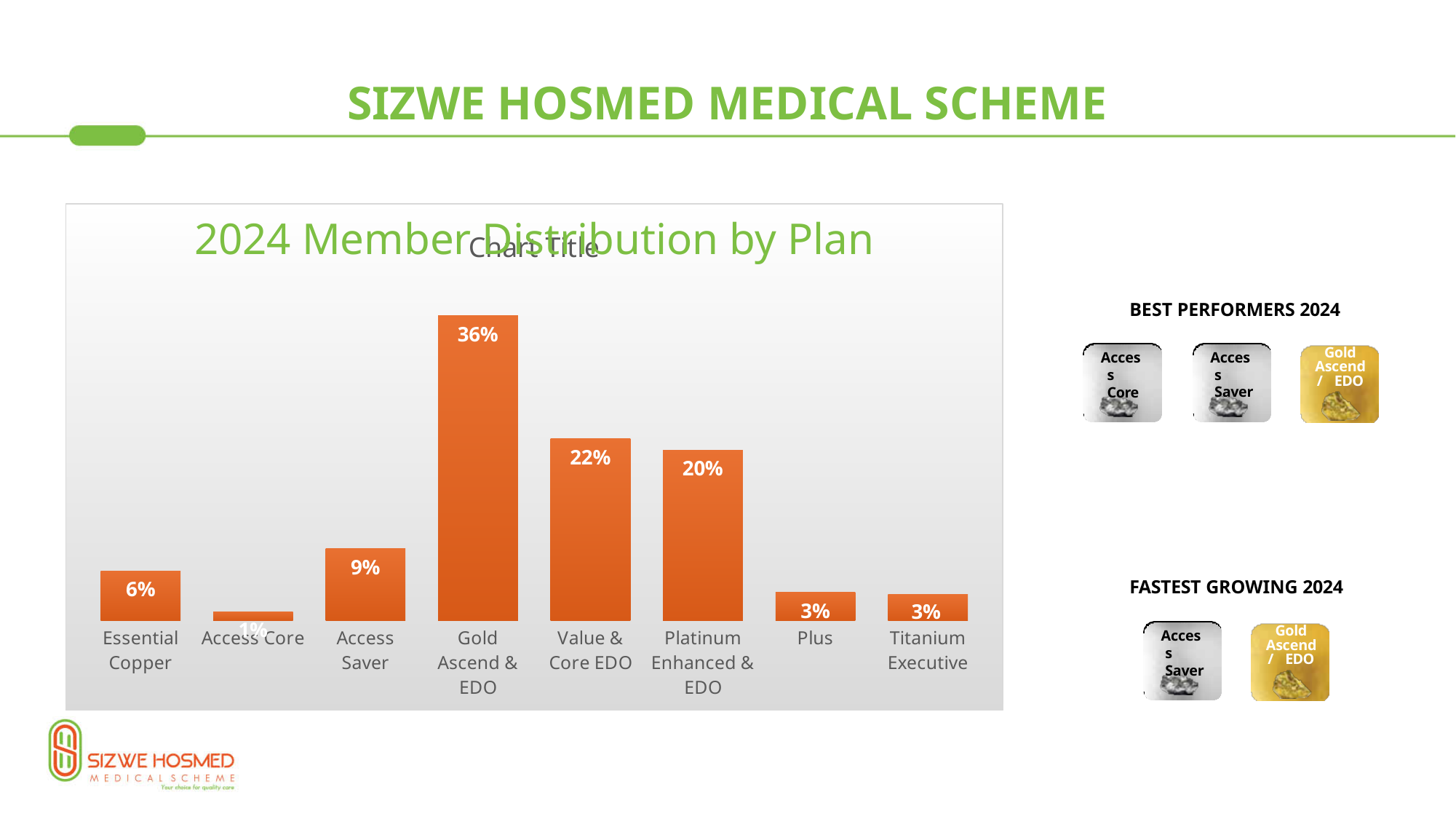
What is the difference between Access Saver and Essential Copper? 3% Which plan has the highest share of members? Gold Ascend & EDO What is the value for Access Saver? 9% How many plans are shown on the chart? 8 What type of chart is shown on the slide? Bar chart What is the difference between the Gold Ascend & EDO value and the Value & Core EDO value? 14% Which is larger, Value & Core EDO or Platinum Enhanced & EDO? Value & Core EDO What is the value shown for Essential Copper? 6% What percentage of members are on the Gold Ascend & EDO plan? 36% What is the green title shown above the chart? 2024 Member Distribution by Plan What percentage is shown for Platinum Enhanced & EDO? 20% Which plan has the lowest share of members? Access Core